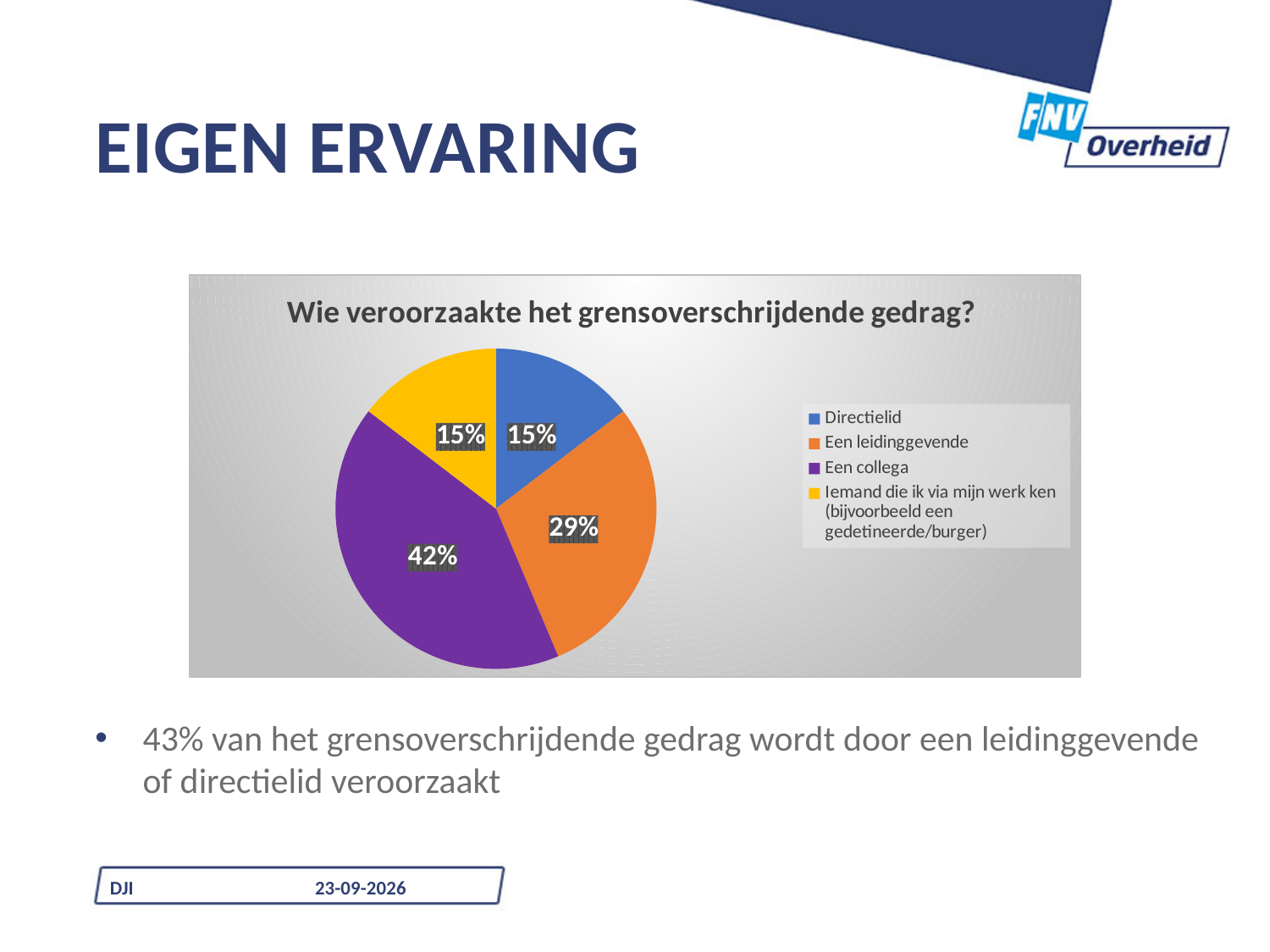
Which colour represents 'Een collega' in the pie chart? Purple What share of the pie is labelled 'Directielid'? 15% What share of the pie is labelled 'Een collega'? 42% What share of the pie is labelled 'Iemand die ik via mijn werk ken (bijvoorbeeld een gedetineerde/burger)'? 15% What type of chart is shown on the slide? Pie chart How many categories does the legend list? 4 What is the combined share of 'Directielid' and 'Een leidinggevende'? 44% What is the title of the chart? Wie veroorzaakte het grensoverschrijdende gedrag? Which is larger, the share for 'Een leidinggevende' or the share for 'Directielid'? Een leidinggevende What share of the pie is labelled 'Een leidinggevende'? 29% Which category has the largest slice of the pie? Een collega What is the difference between the shares for 'Een collega' and 'Een leidinggevende'? 13%